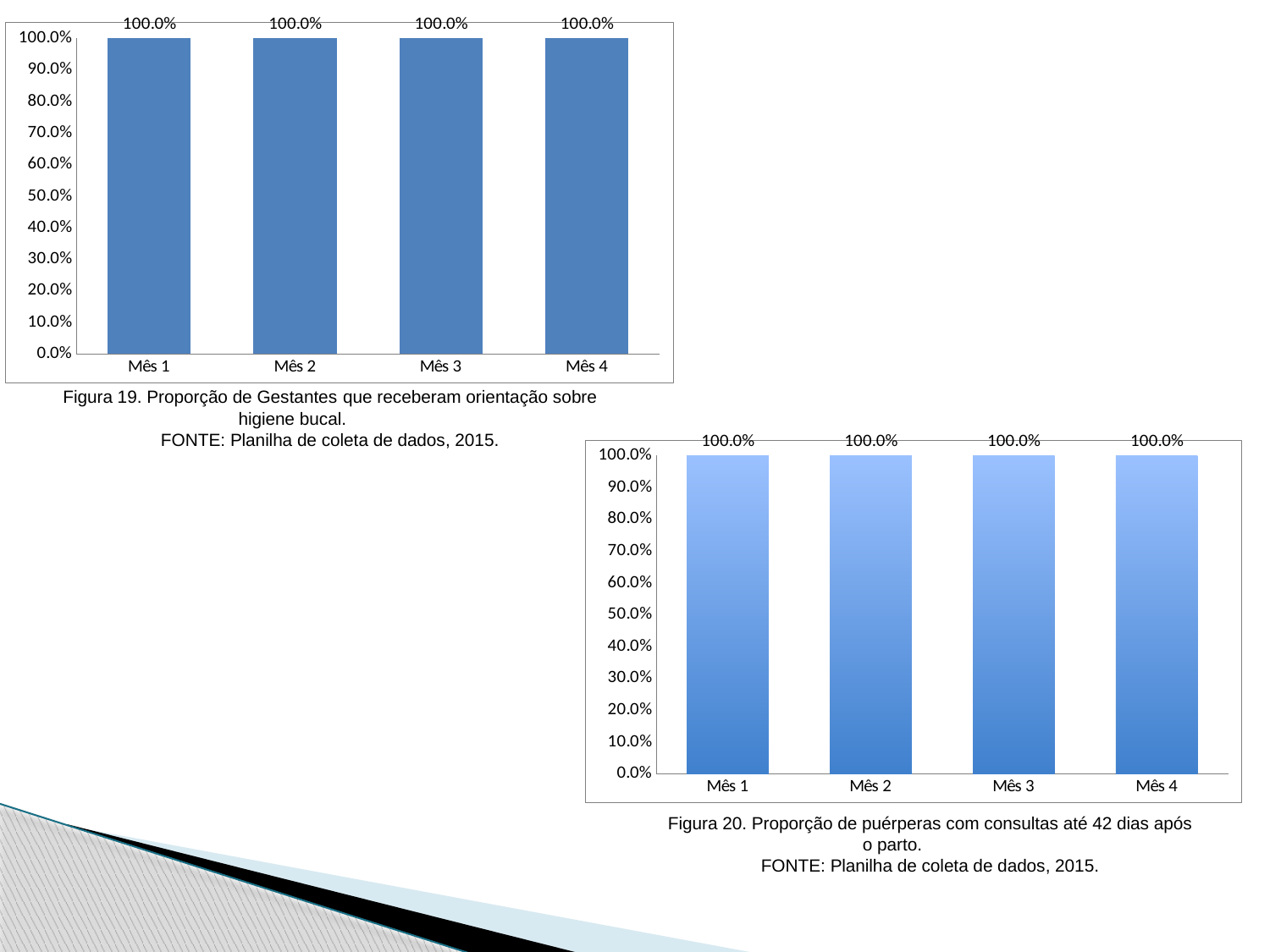
In the Figura 20 chart (bottom right), what is the value for Mês 2? 100.0% How many categories are shown on the x axis of the Figura 19 chart (top left)? 4 What is the caption title of the chart at the bottom right of the slide? Figura 20. Proporção de puérperas com consultas até 42 dias após o parto. In the Figura 19 chart (top left), what is the value for Mês 4? 100.0% In the Figura 19 chart (top left), what is the value for Mês 1? 100.0% In the Figura 19 chart (top left), what is the difference between the values for Mês 1 and Mês 3? 0.0% In the Figura 19 chart (top left), is the value for Mês 2 greater or less than 50.0%? greater How many bars are plotted in the Figura 20 chart (bottom right)? 4 What kind of chart is the Figura 19 chart (top left)? Bar chart What kind of chart is the Figura 20 chart (bottom right)? Bar chart In the Figura 20 chart (bottom right), what is the value for Mês 3? 100.0% In the Figura 20 chart (bottom right), do the values rise, fall or stay the same from Mês 1 to Mês 4? Stay the same